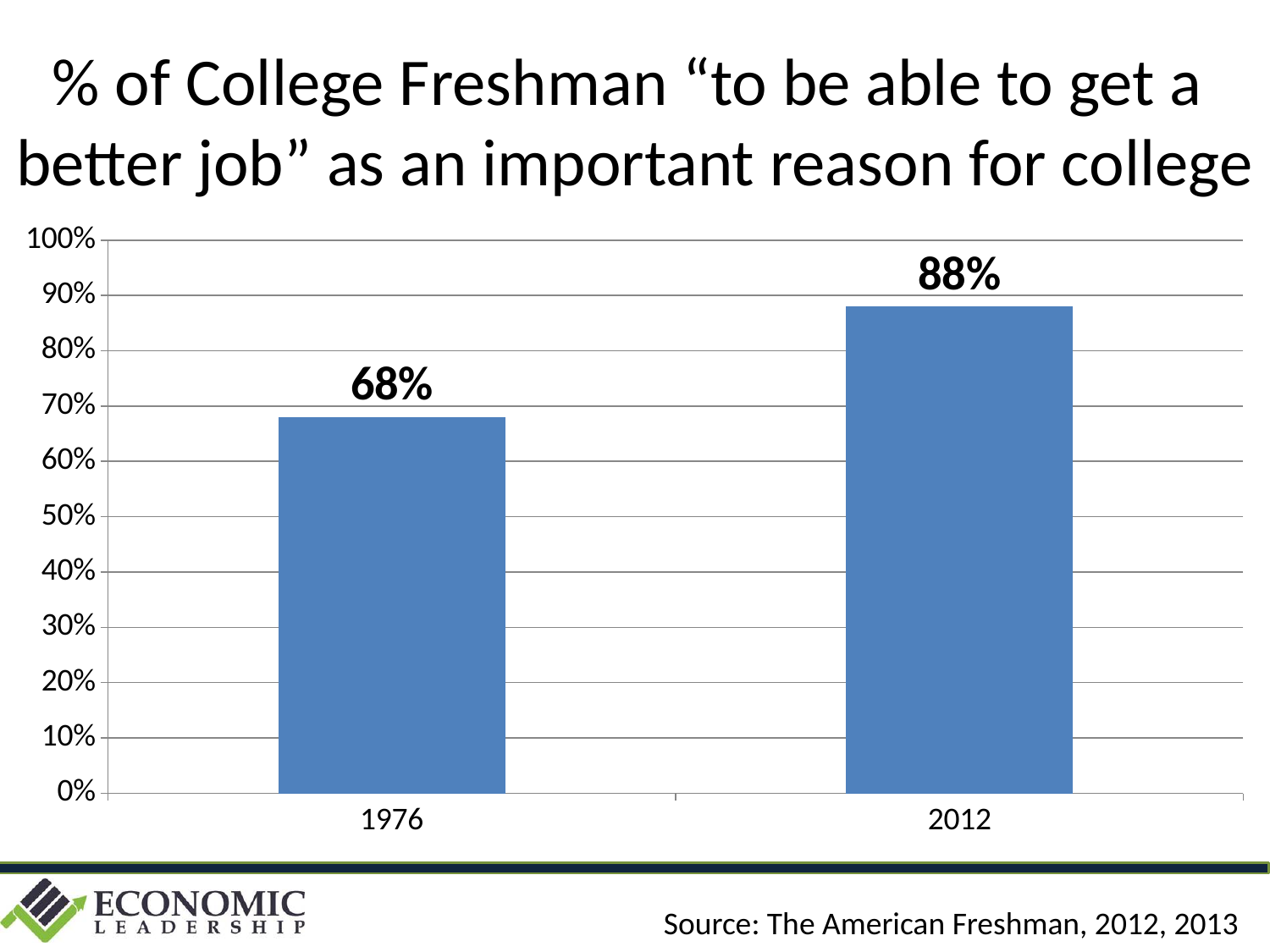
Is the value for 1976 greater or less than 70%? less Which is larger, the value for 1976 or the value for 2012? 2012 How many years are shown on the chart? 2 What kind of chart is shown on the slide? bar chart Which year has the lowest value? 1976 Which year has the highest value? 2012 What is the value for 2012? 88% Do the values rise or fall from 1976 to 2012? rise What is the source cited for the chart? The American Freshman, 2012, 2013 What is the difference between the values for 2012 and 1976? 20% Is the value for 2012 greater or less than 80%? greater What is the value for 1976? 68%